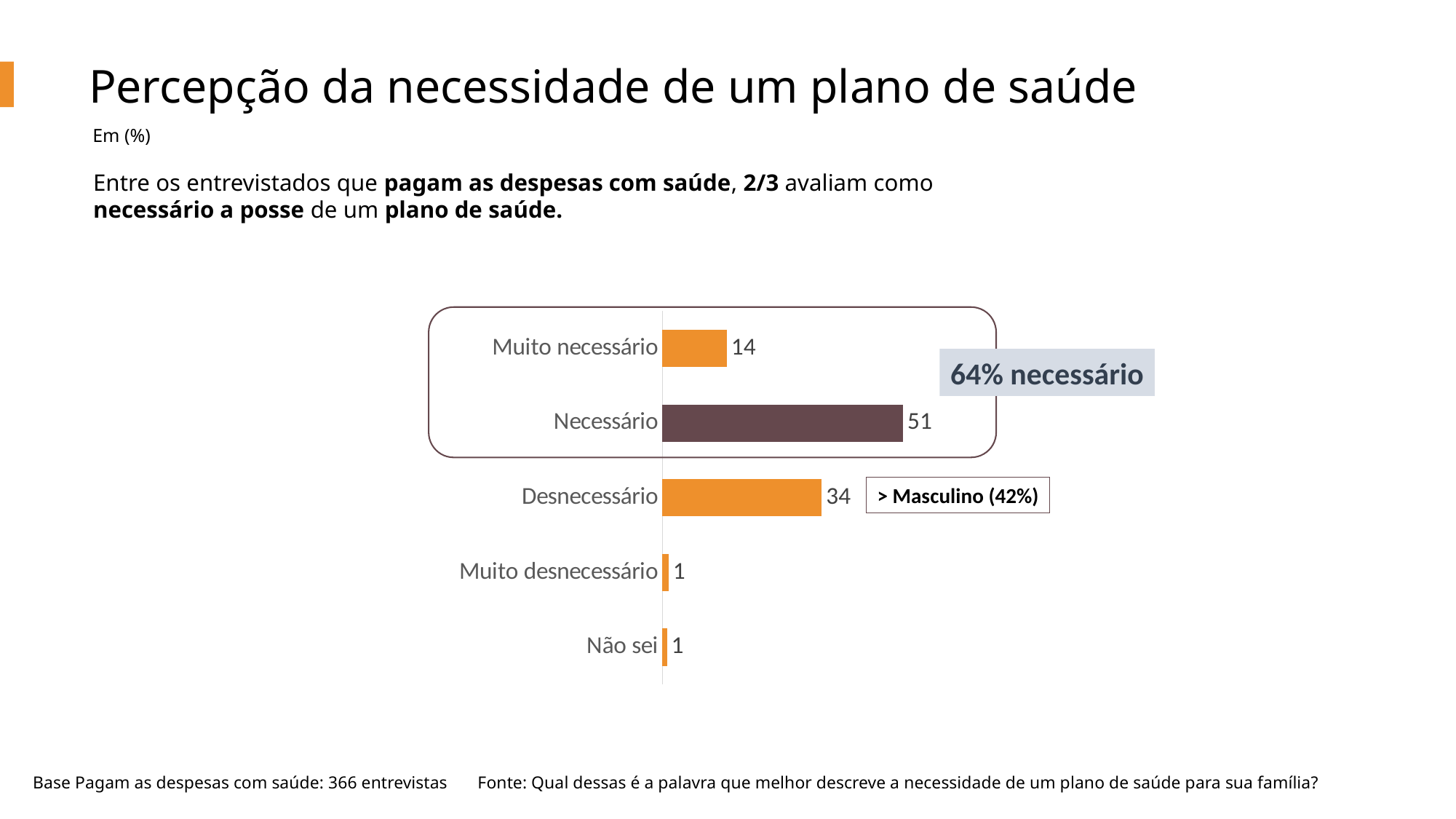
What is the difference between the values for Necessário and Desnecessário? 17 Which category has the highest value? Necessário What is the value for Necessário? 51 What percentage is shown in the highlighted box next to the chart? 64% What is the difference between the values for Desnecessário and Muito necessário? 20 What is the value for Desnecessário? 34 How many categories are shown in the chart? 5 What is the value for Muito necessário? 14 What is the combined value of Muito necessário and Necessário? 65 Which is larger, the value for Muito necessário or the value for Desnecessário? Desnecessário What kind of chart is shown on the slide? Bar chart What is the value for Muito desnecessário? 1